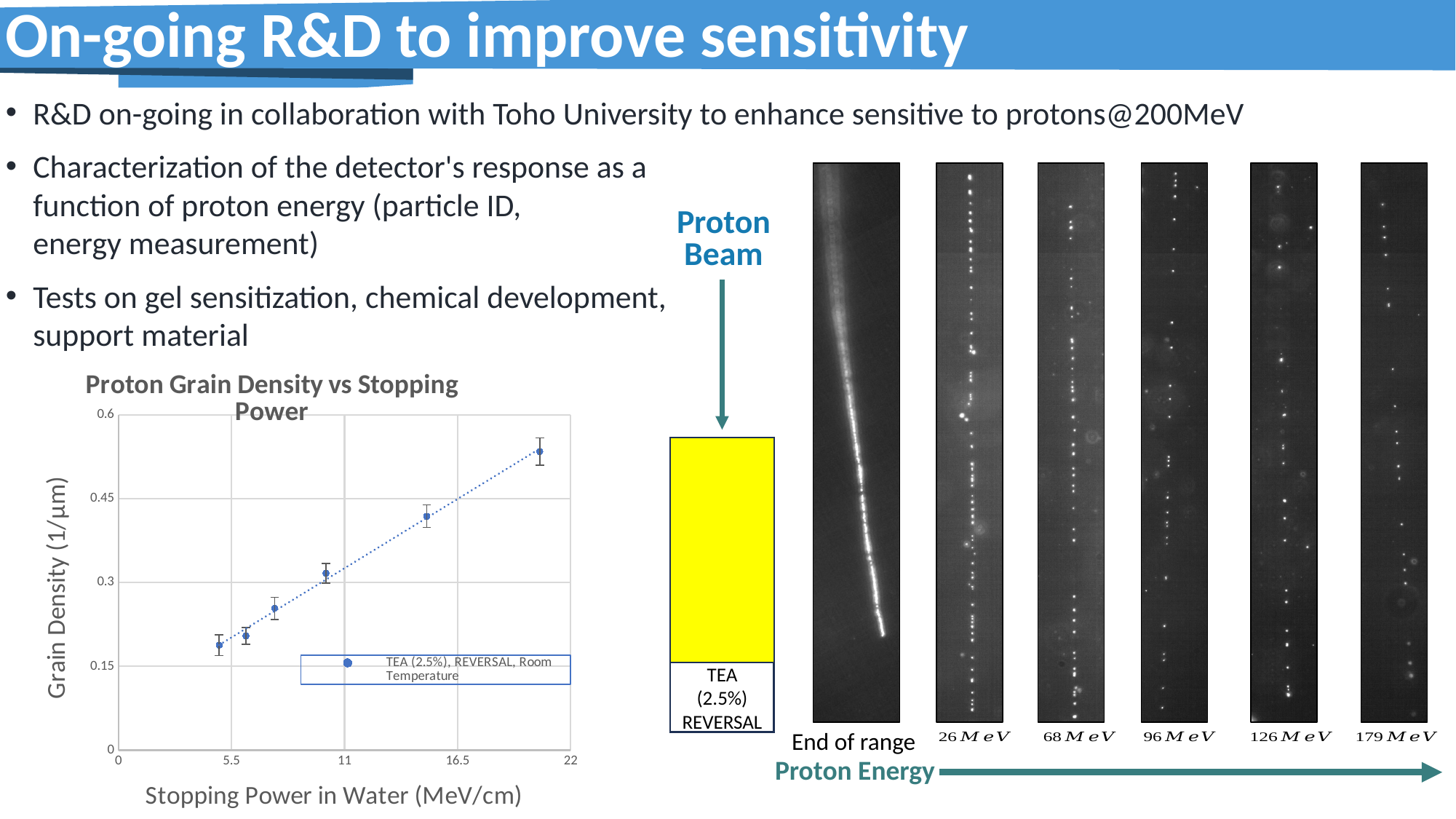
Is the grain density of the leftmost data point (near 5 MeV/cm) greater or less than 0.3? less Is the grain density of the leftmost data point (near 5 MeV/cm) greater or less than 0.15? greater What is the title of the chart on the slide? Proton Grain Density vs Stopping Power What is the legend entry of the series in the chart? TEA (2.5%), REVERSAL, Room Temperature Does grain density rise or fall as stopping power increases along the x axis? Rise How many data points are plotted in the Proton Grain Density vs Stopping Power chart? 6 Which has the larger grain density: the point near 7 MeV/cm or the point near 14.5 MeV/cm? The point near 14.5 MeV/cm Is the grain density of the rightmost data point (near 20 MeV/cm) greater or less than 0.45? greater What is the label of the x axis of the chart? Stopping Power in Water (MeV/cm) What kind of chart is shown on the slide? Scatter plot How many series does the legend of the chart list? 1 Which data point has the highest grain density: the one at the lowest stopping power or the one at the highest stopping power? The one at the highest stopping power